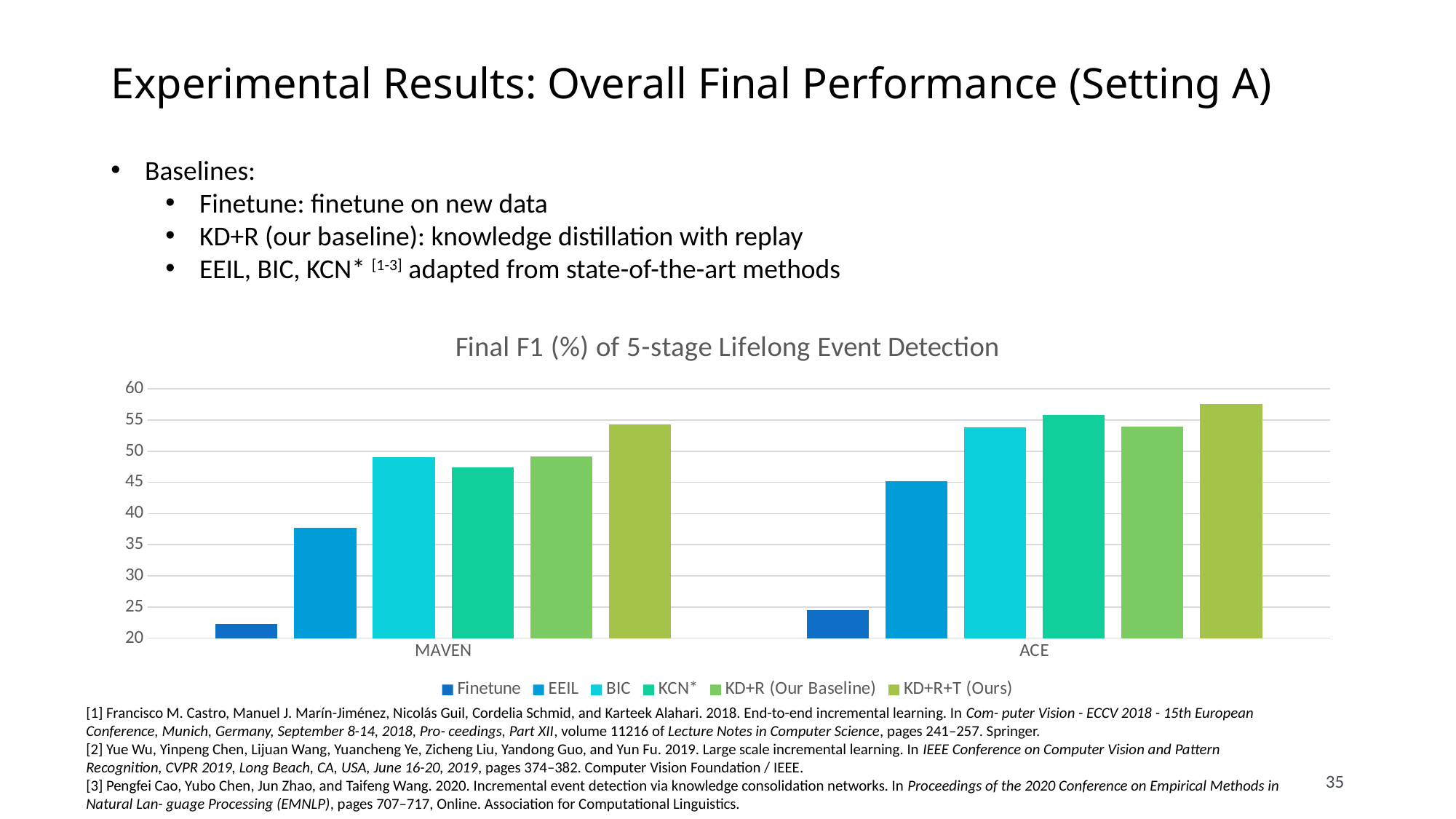
How many series does the legend list? 6 What is the title of the chart? Final F1 (%) of 5-stage Lifelong Event Detection Is the value for Finetune on MAVEN greater or less than 25? less Which series has the lowest value for ACE? Finetune Is the value for KD+R+T (Ours) on ACE greater or less than 55? greater How many dataset categories are shown on the x axis? 2 Which series has the highest value for MAVEN? KD+R+T (Ours) Is the value for EEIL on MAVEN greater or less than 40? less What type of chart is shown on the slide? bar chart Which is larger for ACE: the value for EEIL or the value for KCN*? KCN* Which is larger for MAVEN: the value for KD+R+T (Ours) or the value for KCN*? KD+R+T (Ours) Which series has the highest value for ACE? KD+R+T (Ours)